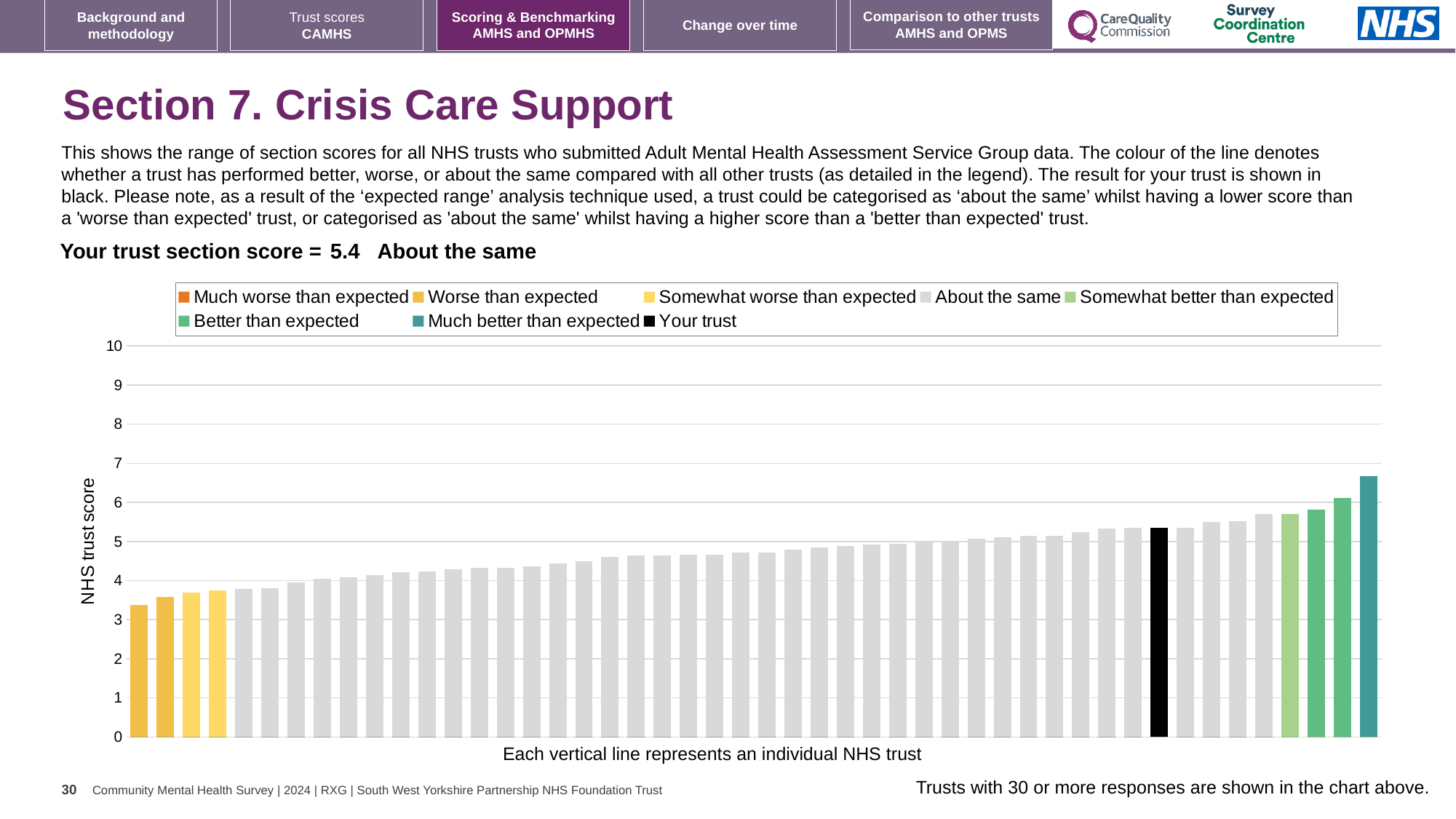
How many entries does the chart legend list? 8 Which legend category does the tallest bar belong to? Much better than expected What is the section score for your trust shown on the slide? 5.4 What kind of chart is shown on the slide? bar chart Which category is your trust placed in for this section? About the same Is the value of the black 'Your trust' bar greater or less than 5? greater What is the label on the vertical axis of the chart? NHS trust score Do the bar values rise or fall from left to right along the x axis? rise How many bars are coloured as 'Worse than expected' (yellow)? 2 Which legend category does the shortest bar belong to? Worse than expected Is the value of the leftmost bar greater or less than 4? less Is the value of the tallest bar (rightmost, teal) greater or less than 6? greater